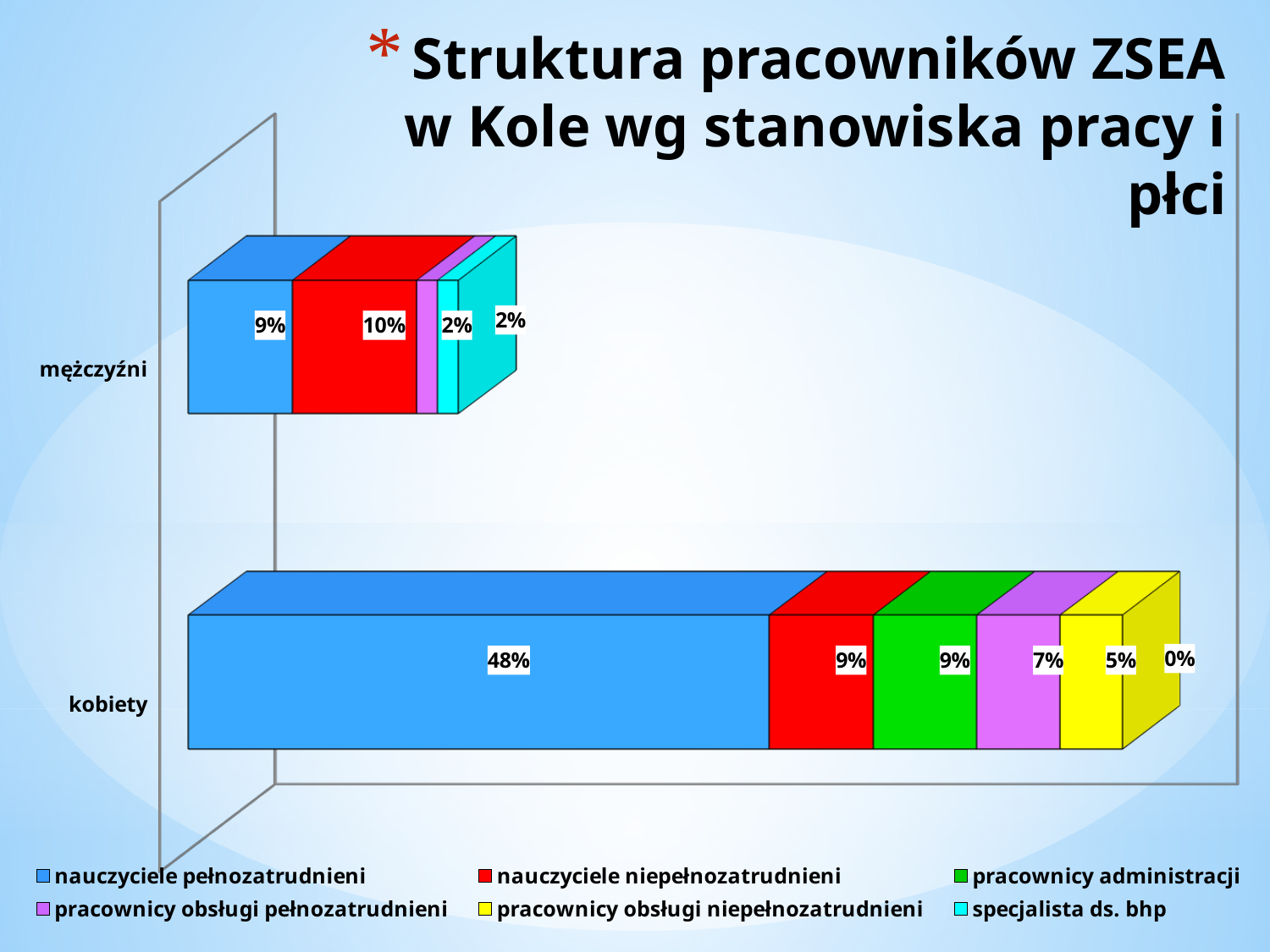
What kind of chart is shown on the slide? Stacked bar chart What is the value for specjalista ds. bhp in the kobiety bar? 0% What is the value for nauczyciele niepełnozatrudnieni in the mężczyźni bar? 10% What is the difference between the nauczyciele pełnozatrudnieni values for kobiety and mężczyźni? 39 percentage points What is the value for pracownicy obsługi niepełnozatrudnieni in the kobiety bar? 5% Which series has the largest segment in the kobiety bar? nauczyciele pełnozatrudnieni What is the value for pracownicy obsługi pełnozatrudnieni in the kobiety bar? 7% Which has the larger value for nauczyciele niepełnozatrudnieni, kobiety or mężczyźni? mężczyźni How many categories (bars) are plotted on the chart? 2 What is the value for nauczyciele pełnozatrudnieni in the kobiety bar? 48% What colour represents pracownicy administracji in the legend? Green How many series does the legend list? 6